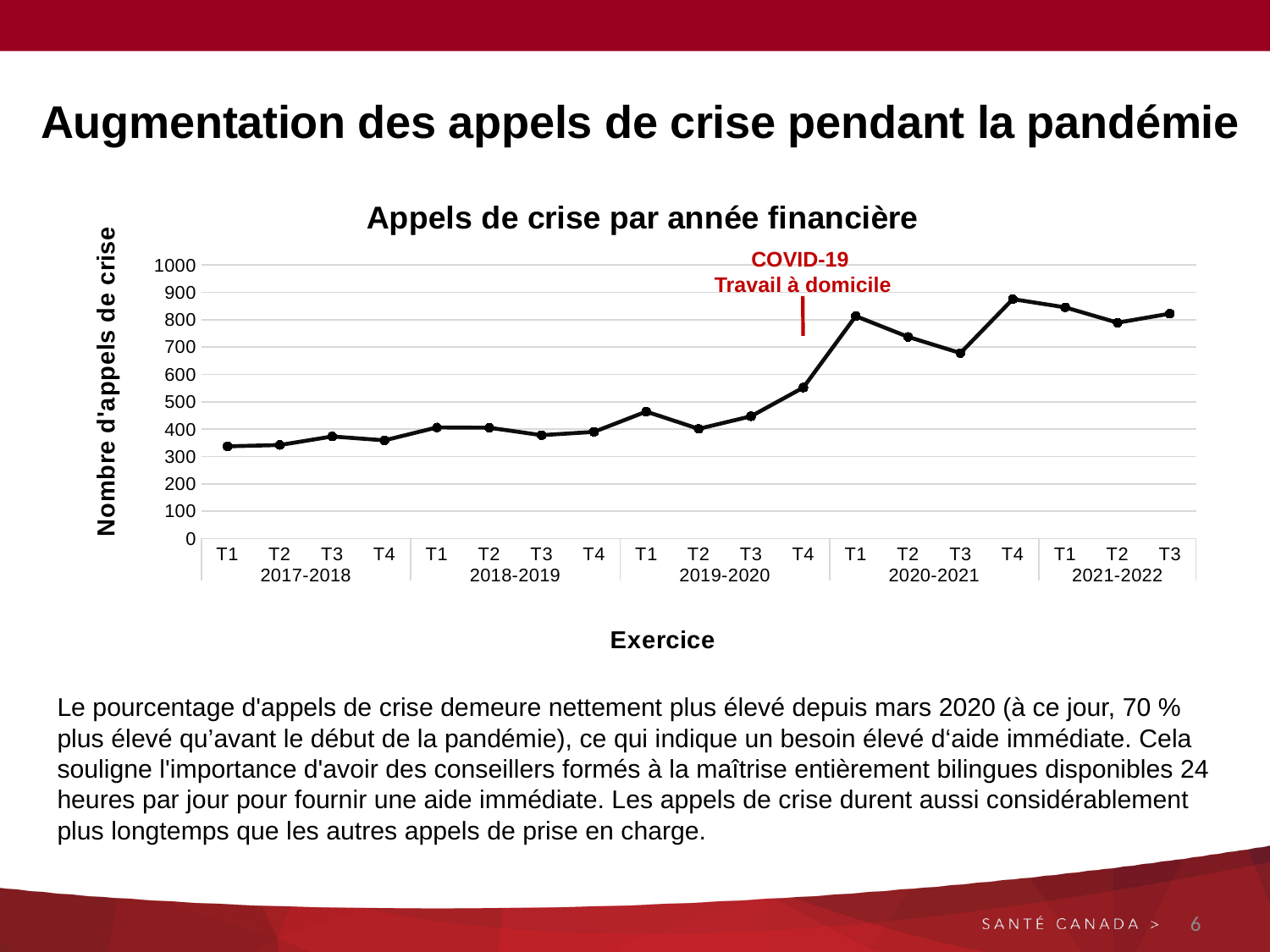
What kind of chart is shown on the slide? Line chart Which is larger, the value for T1 2019-2020 or the value for T2 2019-2020? T1 2019-2020 What event does the red annotation on the chart mark? COVID-19 Travail à domicile Is the value for T4 2020-2021 greater or less than 800? greater Is the value for T4 2019-2020 greater or less than 500? greater Is the value for T1 2017-2018 greater or less than 400? less How many data points are plotted on the line in the chart "Appels de crise par année financière"? 19 Which quarter has the highest number of crisis calls in the chart? T4 2020-2021 How many fiscal years (années financières) are shown along the x axis of the chart? 5 Which is larger, the value for T3 2020-2021 or the value for T4 2020-2021? T4 2020-2021 Overall, do the number of crisis calls rise or fall from T1 2017-2018 to T3 2021-2022? Rise